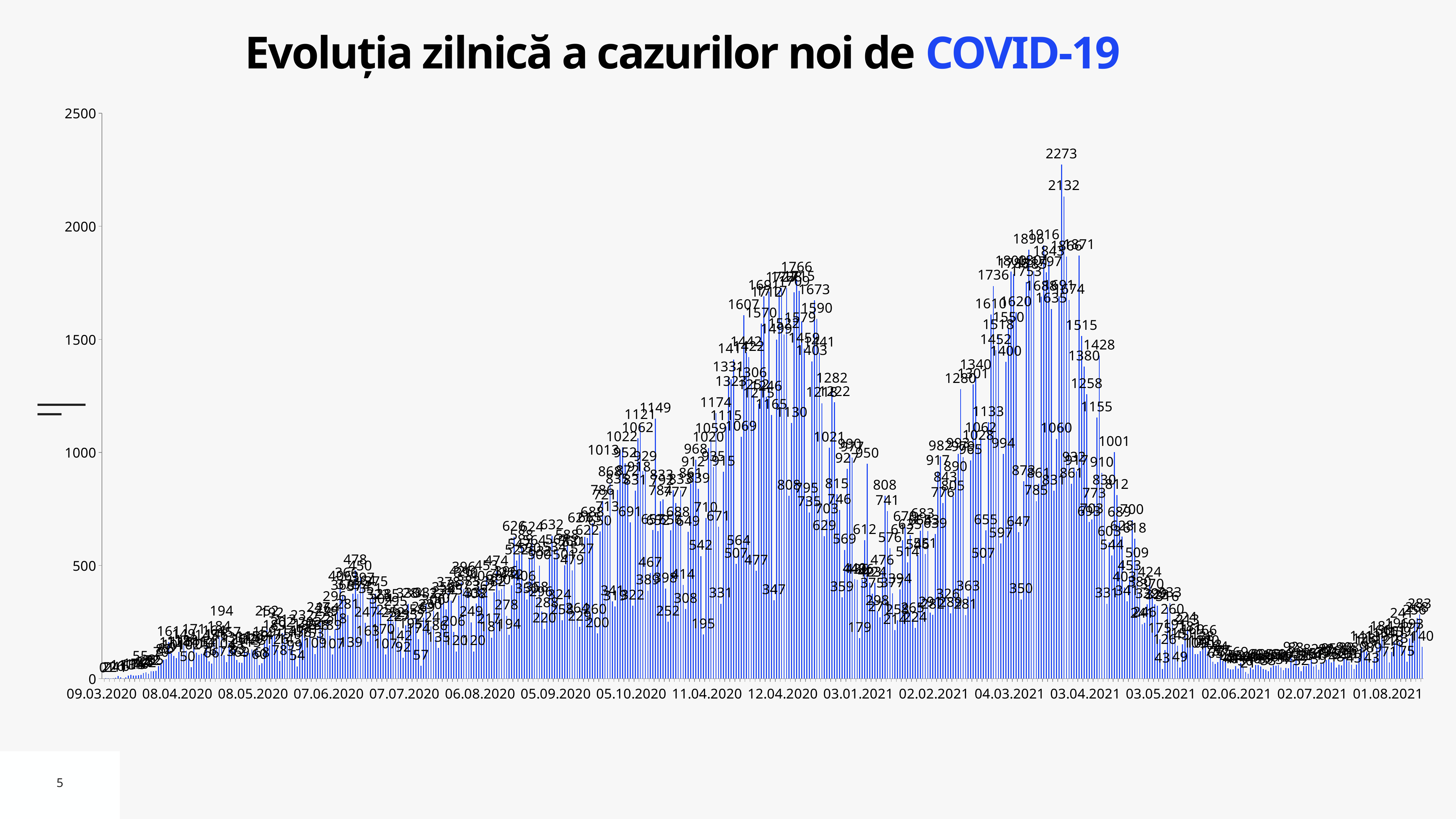
Between 02.07.2021 and 01.08.2021, do the daily values rise or fall? rise Is the highest value on the chart greater or less than 2000? greater What kind of chart is shown on the slide? bar chart What is the highest daily value labelled on the chart? 2273 What is the highest labelled value of the wave that peaks around 12.04.2020? 1766 What is the first date shown on the x axis? 09.03.2020 What is the title of the chart? Evoluția zilnică a cazurilor noi de COVID-19 Is the highest value on the chart greater or less than 2500? less What is the second-highest daily value labelled on the chart? 2132 What is the difference between the two highest labelled values, 2273 and 2132? 141 Between 03.04.2021 and 03.05.2021, do the daily values rise or fall? fall Which is higher, the peak of the wave around 12.04.2020 or the peak of the wave around 03.04.2021? the peak around 03.04.2021